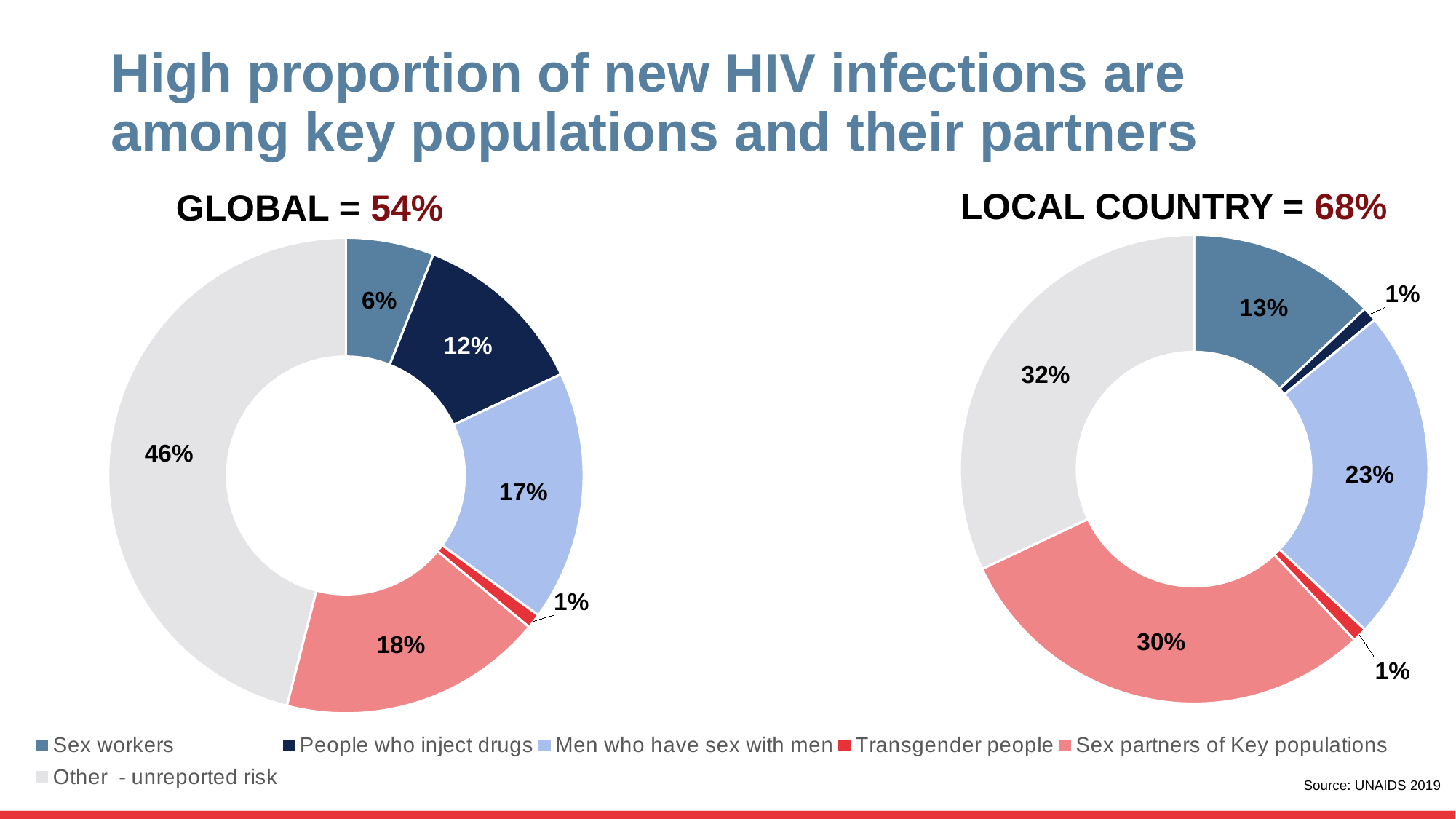
In the LOCAL COUNTRY chart, which category has the largest share? Other - unreported risk In the GLOBAL chart, which category has the largest share? Other - unreported risk How many categories does the legend list? 6 In the LOCAL COUNTRY chart, what percentage is shown for Sex workers? 13% In the GLOBAL chart, what percentage is shown for Men who have sex with men? 17% In the GLOBAL chart, what is the difference between the share for Sex partners of Key populations and the share for Sex workers? 12% Which chart shows a larger share for Sex workers, GLOBAL or LOCAL COUNTRY? LOCAL COUNTRY What kind of chart is used on this slide? Donut (pie) chart In the LOCAL COUNTRY chart, what percentage is shown for Sex partners of Key populations? 30% In the LOCAL COUNTRY chart, what is the difference between the share for Other - unreported risk and the share for Men who have sex with men? 9% In the GLOBAL chart, what percentage is shown for People who inject drugs? 12% What percentage is shown in the title of the LOCAL COUNTRY chart? 68%